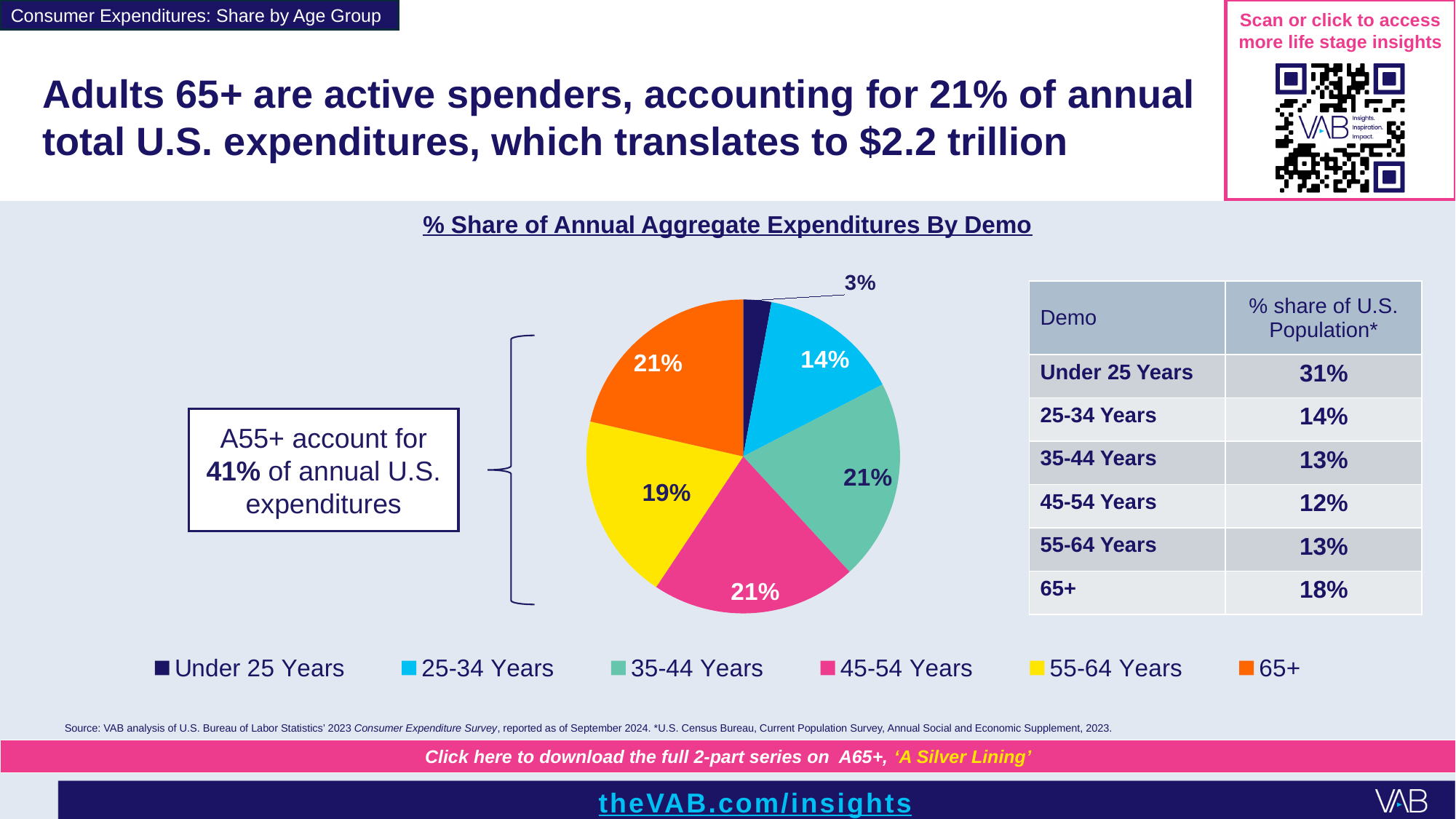
What share of annual aggregate expenditures does the Under 25 Years slice represent? 3% How many entries does the chart legend list? 6 Which age group has the smallest slice of the pie chart? Under 25 Years How many slices does the pie chart have? 6 What is the difference in percentage points between the 55-64 Years slice and the Under 25 Years slice? 16 What is the value shown for the 55-64 Years slice? 19% Which slice is larger, 25-34 Years or 55-64 Years? 55-64 Years What share of annual aggregate expenditures does the 65+ slice represent? 21% What colour is the 65+ slice in the pie chart? orange What is the value shown for the 25-34 Years slice? 14% What kind of chart is shown on the slide? pie chart What is the title of the chart? % Share of Annual Aggregate Expenditures By Demo